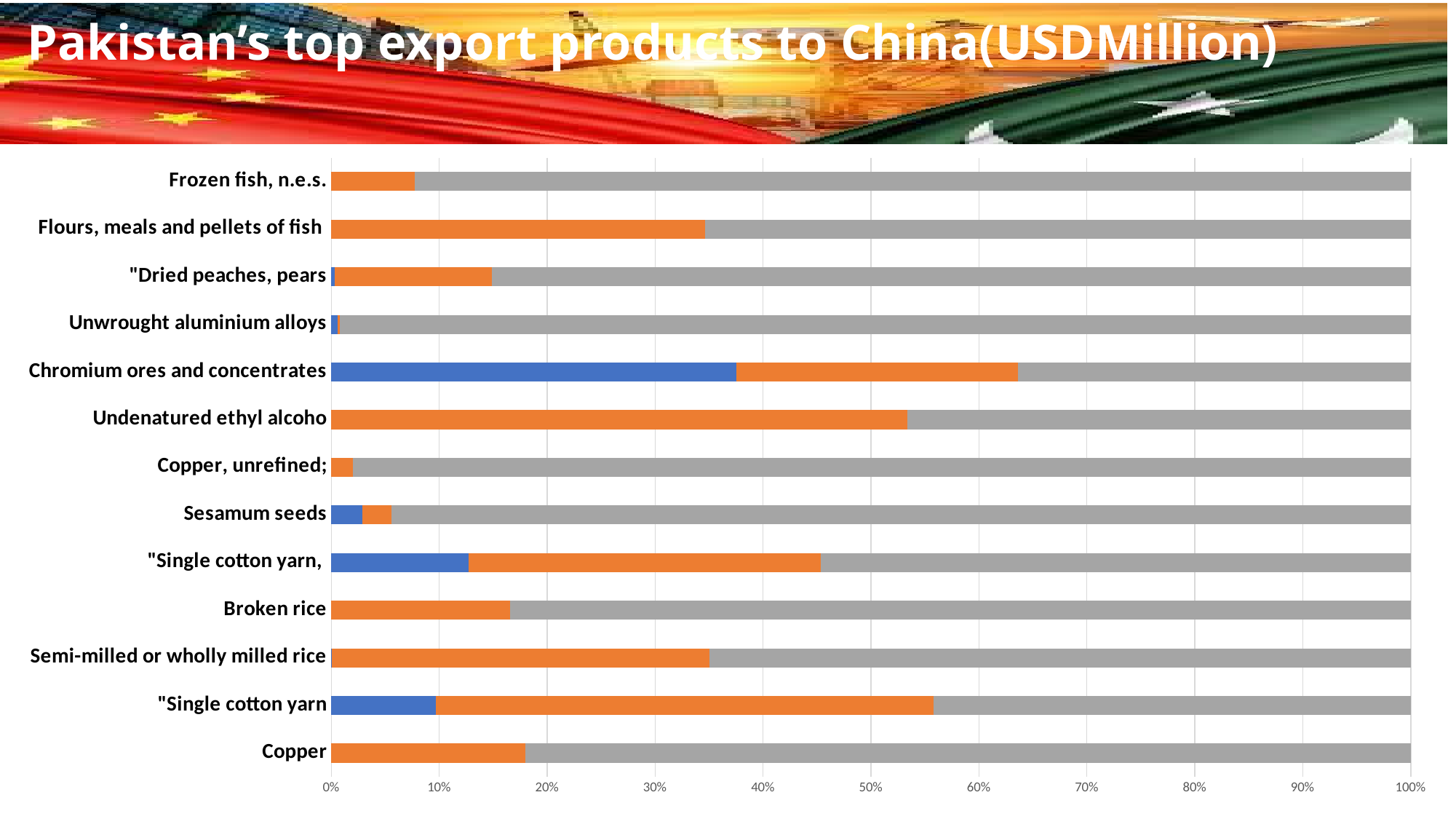
Is the blue segment for Chromium ores and concentrates greater or less than 30%? greater Is the orange segment for Flours, meals and pellets of fish greater or less than 30%? greater What kind of chart is shown on the slide? Bar chart Which has the larger orange segment: Broken rice or Semi-milled or wholly milled rice? Semi-milled or wholly milled rice Which has the larger blue segment: Chromium ores and concentrates or "Single cotton yarn (the second bar from the bottom)? Chromium ores and concentrates Is the orange segment for Frozen fish, n.e.s. greater or less than 10%? less What is the highest value shown on the horizontal axis of the chart? 100% What is the title of the chart on the slide? Pakistan's top export products to China(USDMillion) How many product categories are listed on the vertical axis of the chart? 13 Which category has the largest blue segment in the chart? Chromium ores and concentrates